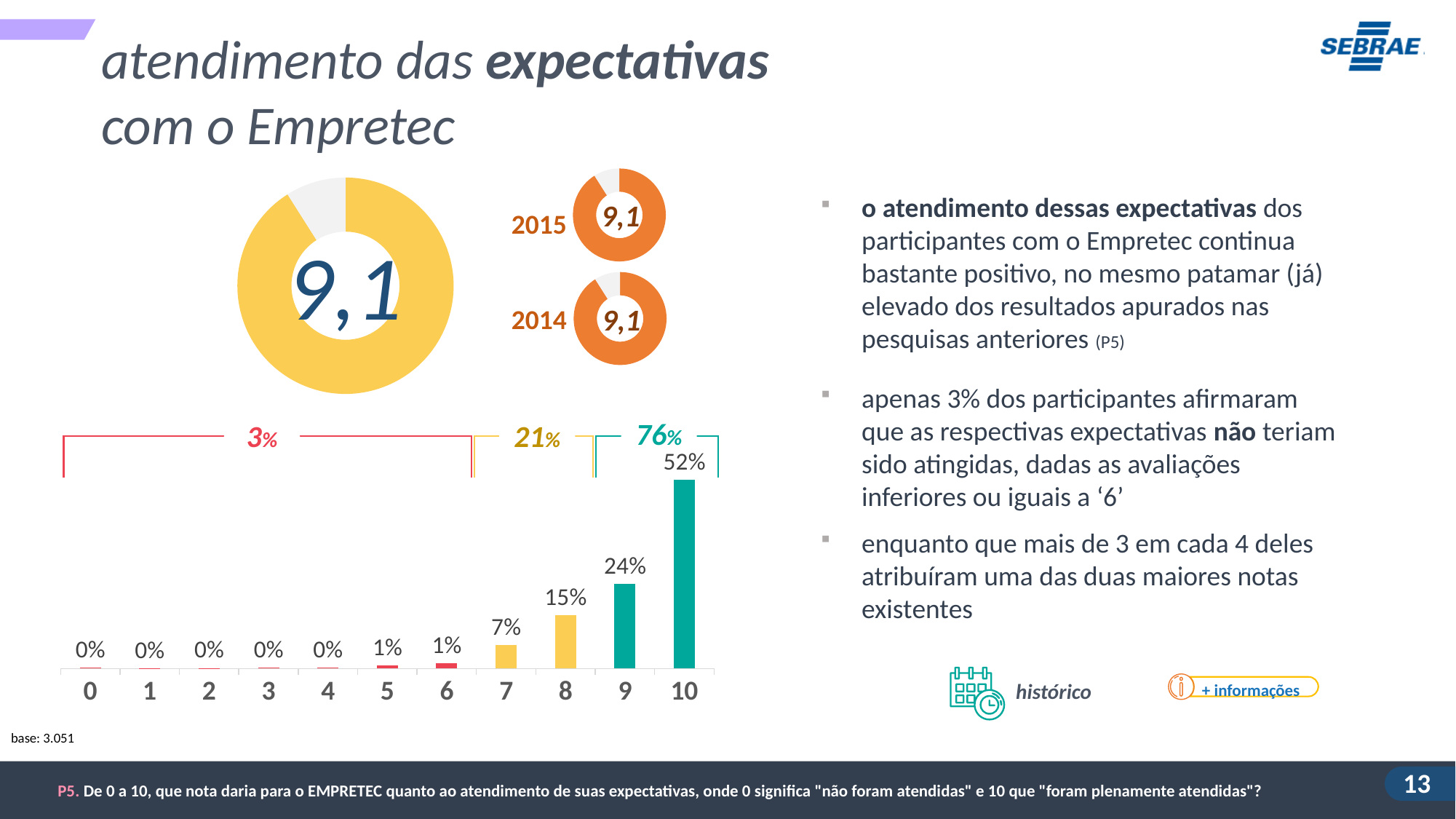
In the bar chart, what is the difference between the percentages for scores 10 and 9? 28% What combined percentage is shown above the bars for scores 9 and 10? 76% In the bar chart, which is larger: the percentage for score 7 or for score 8? 8 What kind of chart shows the distribution of scores from 0 to 10? bar chart In the bar chart, which score has the highest percentage? 10 In the bar chart, what percentage of participants gave a score of 10? 52% What combined percentage is shown above the bars for scores 0 to 6? 3% In the bar chart, what percentage of participants gave a score of 8? 15% In the bar chart, do the percentages rise or fall as the score increases from 7 to 10? rise What value is shown in the large yellow donut chart? 9,1 What value is shown in the orange donut chart labelled 2014? 9,1 How many score categories are shown on the x axis of the bar chart? 11